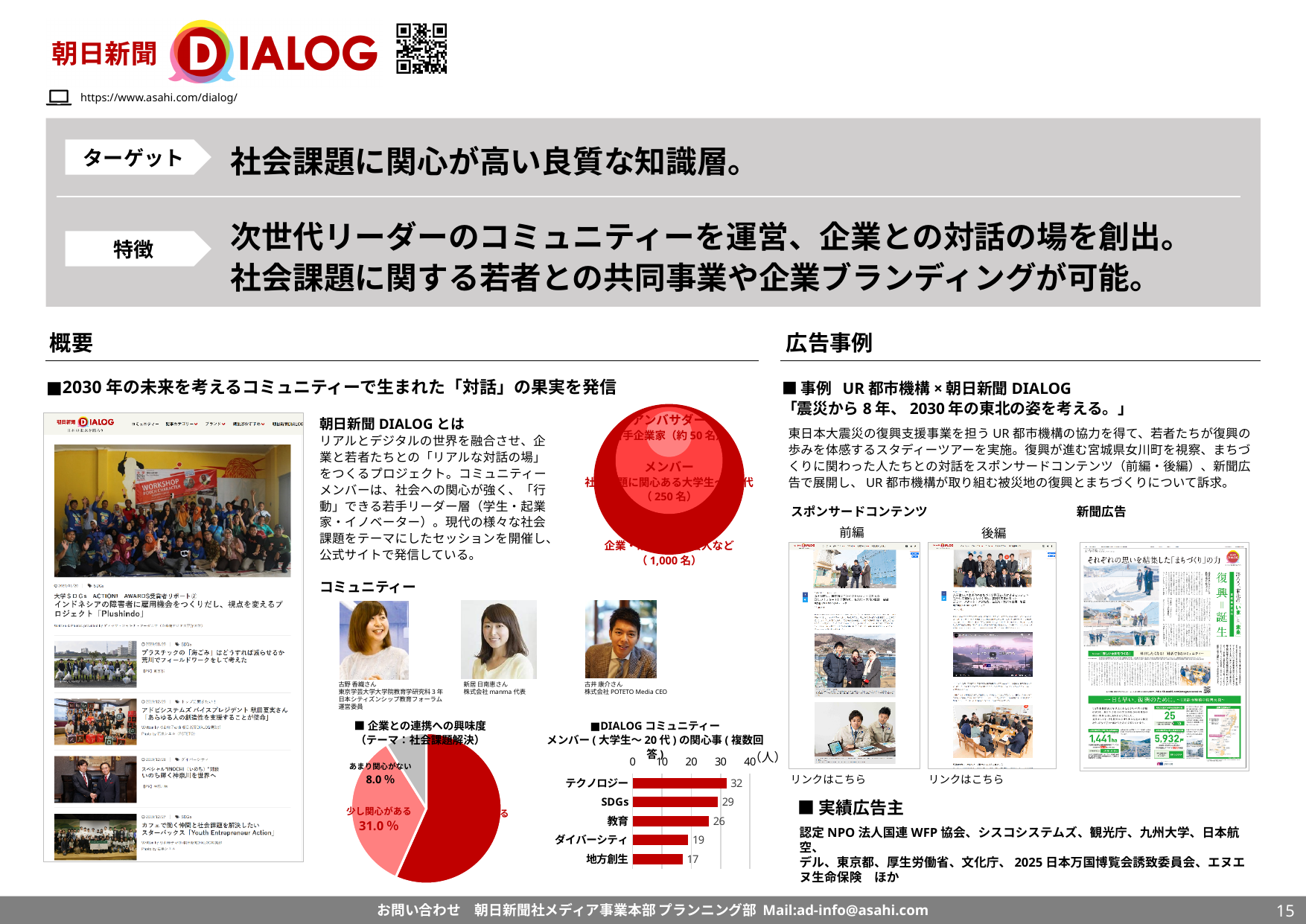
In the bar chart titled 「DIALOG コミュニティーメンバーの関心事」, what is the value for テクノロジー? 32 How many categories are shown in the bar chart titled 「DIALOG コミュニティーメンバーの関心事」? 5 In the bar chart titled 「DIALOG コミュニティーメンバーの関心事」, what is the value for 地方創生? 17 In the bar chart titled 「DIALOG コミュニティーメンバーの関心事」, what is the difference between the values for テクノロジー and ダイバーシティ? 13 What kind of chart is the chart titled 「DIALOG コミュニティーメンバーの関心事」? bar chart In the bar chart titled 「DIALOG コミュニティーメンバーの関心事」, which category has the lowest value? 地方創生 In the bar chart titled 「DIALOG コミュニティーメンバーの関心事」, which category has the highest value? テクノロジー In the bar chart titled 「DIALOG コミュニティーメンバーの関心事」, what is the value for 教育? 26 In the pie chart titled 「企業との連携への興味度」, what is the share for あまり関心がない? 8.0% In the pie chart titled 「企業との連携への興味度」, what is the share for 少し関心がある? 31.0% In the bar chart titled 「DIALOG コミュニティーメンバーの関心事」, what is the value for SDGs? 29 In the bar chart titled 「DIALOG コミュニティーメンバーの関心事」, which is larger, SDGs or 教育? SDGs